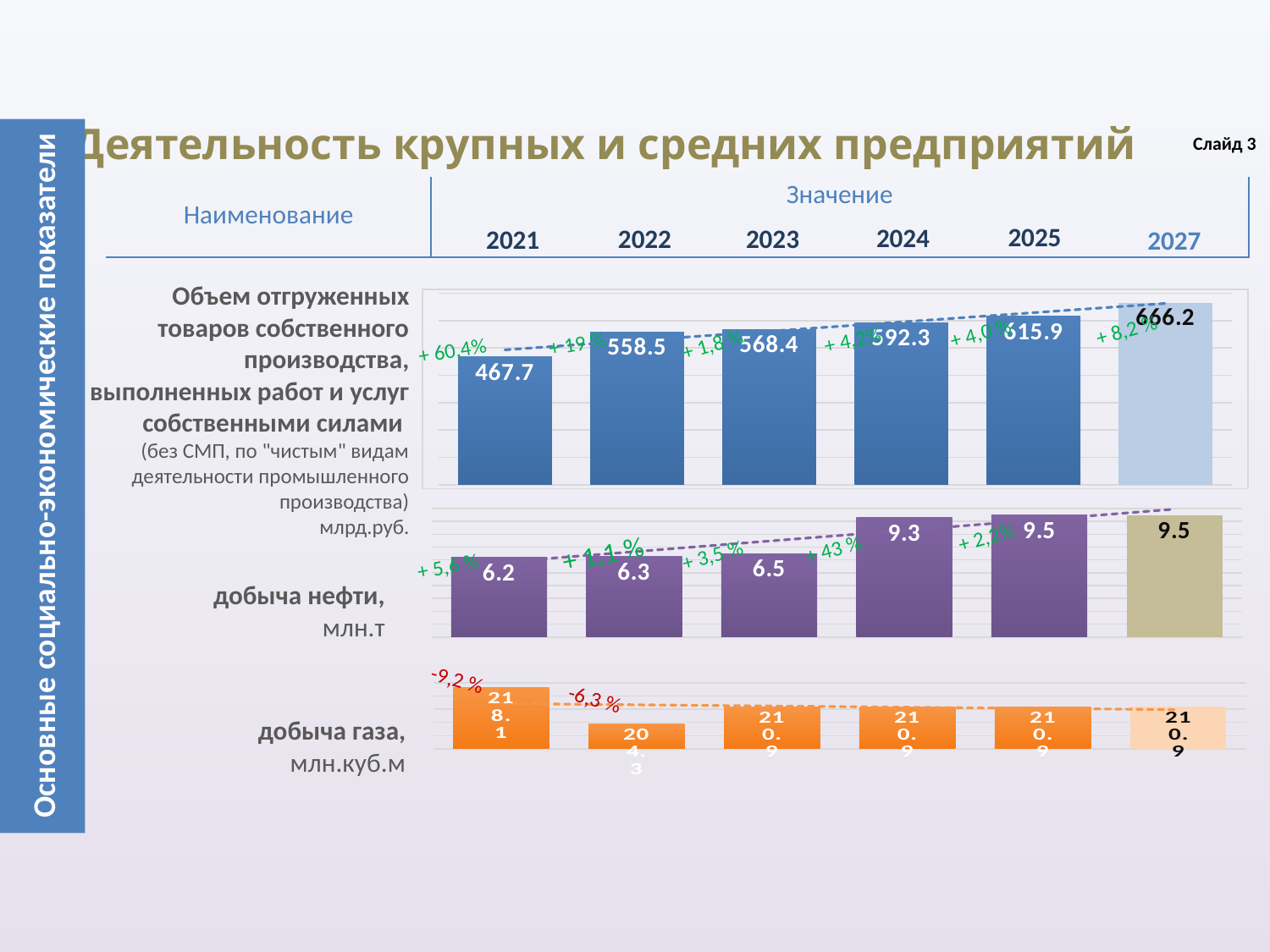
In the middle chart (добыча нефти), which is larger, the value for 2024 or the value for 2022? 2024 In the top chart (Объем отгруженных товаров), which year has the lowest value? 2021 In the top chart (Объем отгруженных товаров), do the values rise or fall from 2021 to 2027? rise In the middle chart (добыча нефти), what is the value for 2023? 6.5 In the top chart (Объем отгруженных товаров), what is the value for 2021? 467.7 In the middle chart (добыча нефти), which year has the lowest value? 2021 In the bottom chart (добыча газа), which year has the highest value? 2021 What type of chart is the middle chart (добыча нефти)? bar chart In the top chart (Объем отгруженных товаров), what is the difference between the 2025 and 2024 values? 23.6 In the bottom chart (добыча газа), what is the value for 2022? 204.3 In the top chart (Объем отгруженных товаров), what is the value for 2027? 666.2 How many years are shown on the x axis of the top chart (Объем отгруженных товаров)? 6